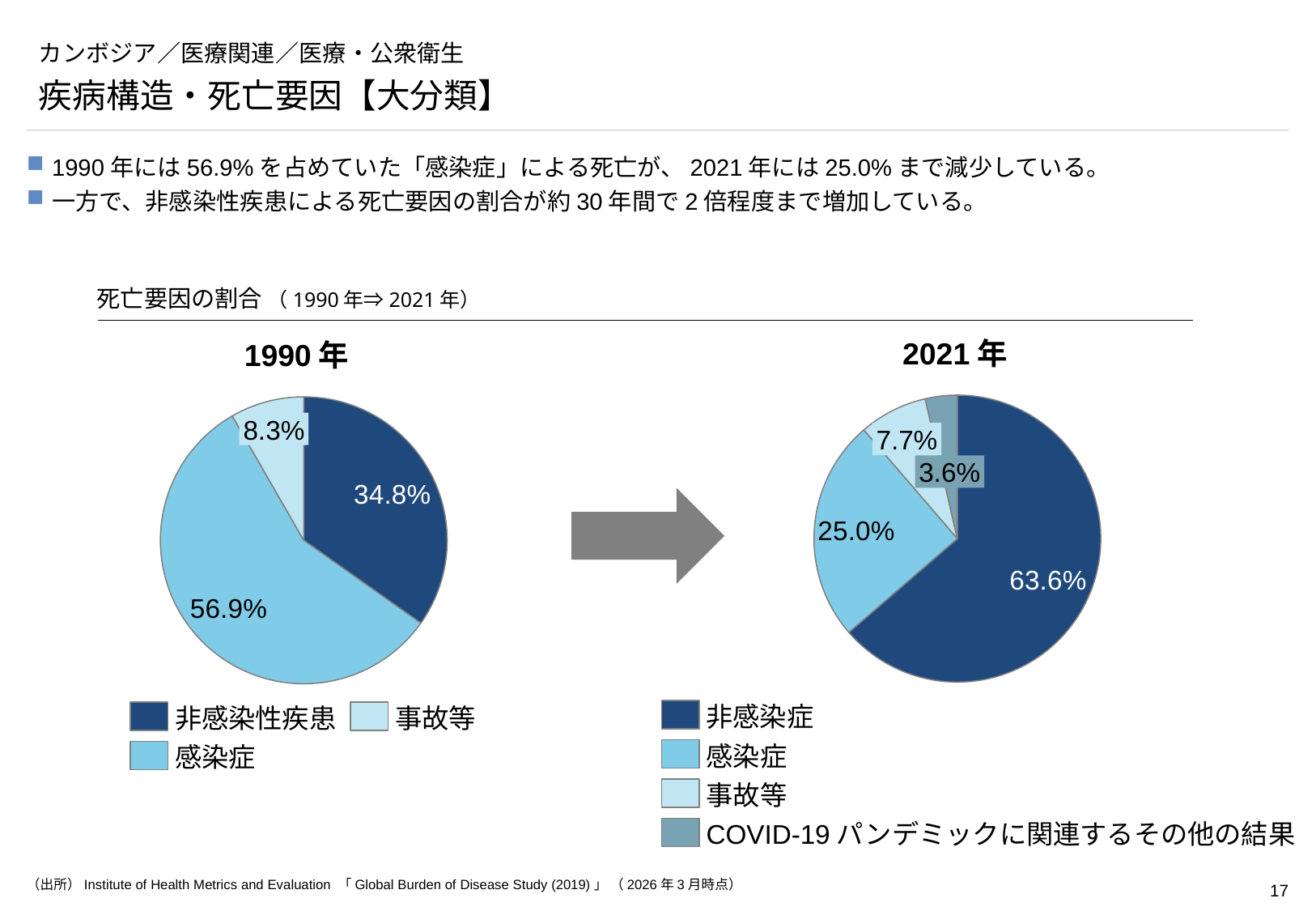
In the 2021年 pie chart, what share is shown for 非感染症? 63.6% Comparing the 1990年 and 2021年 pie charts, which year shows a larger share for 事故等? 1990年 In the 2021年 pie chart, what share is shown for COVID-19 パンデミックに関連するその他の結果? 3.6% What type of chart is used to show 死亡要因の割合 for 1990年 and 2021年? Pie chart In the 2021年 pie chart, which category has the smallest share? COVID-19 パンデミックに関連するその他の結果 In the 2021年 pie chart, what share is shown for 事故等? 7.7% In the 1990年 pie chart, what share is shown for 感染症? 56.9% How many slices does the 2021年 pie chart have? 4 In the 2021年 pie chart, what is the difference between the shares of 非感染症 and 感染症? 38.6% How many entries does the legend of the 1990年 chart list? 3 In the 1990年 pie chart, which category has the largest share? 感染症 In the 1990年 pie chart, what share is shown for 非感染性疾患? 34.8%